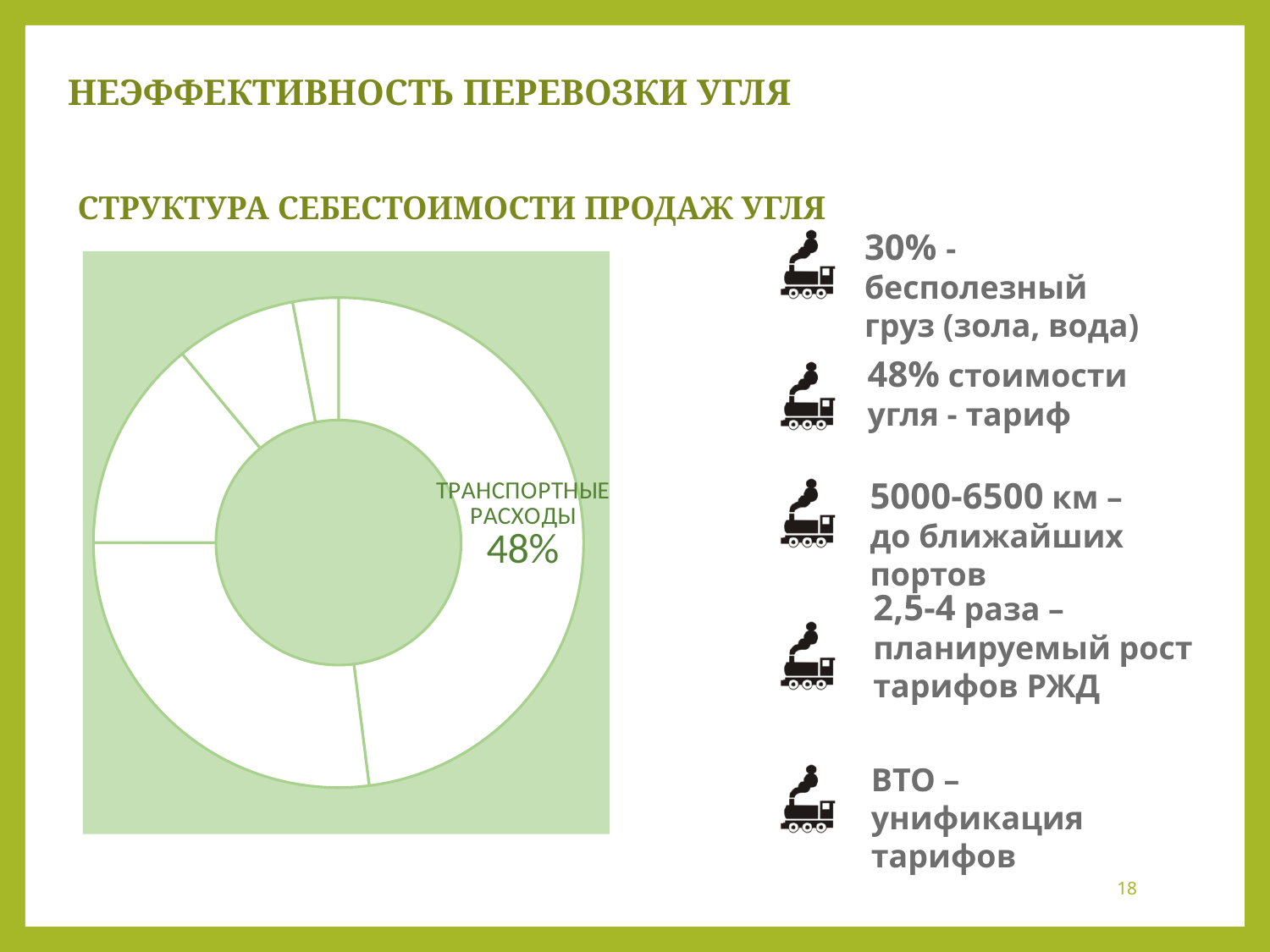
What is the value printed for the ТРАНСПОРТНЫЕ РАСХОДЫ slice? 48% Is the share of ТРАНСПОРТНЫЕ РАСХОДЫ greater or less than 50%? less Which slice of the doughnut chart is the largest? ТРАНСПОРТНЫЕ РАСХОДЫ What is the title of the chart? СТРУКТУРА СЕБЕСТОИМОСТИ ПРОДАЖ УГЛЯ What kind of chart is shown on the slide? doughnut (pie) chart How many slices does the doughnut chart have? 5 What share of the cost structure do transport costs (ТРАНСПОРТНЫЕ РАСХОДЫ) account for? 48% How many slices of the doughnut chart have a printed label? 1